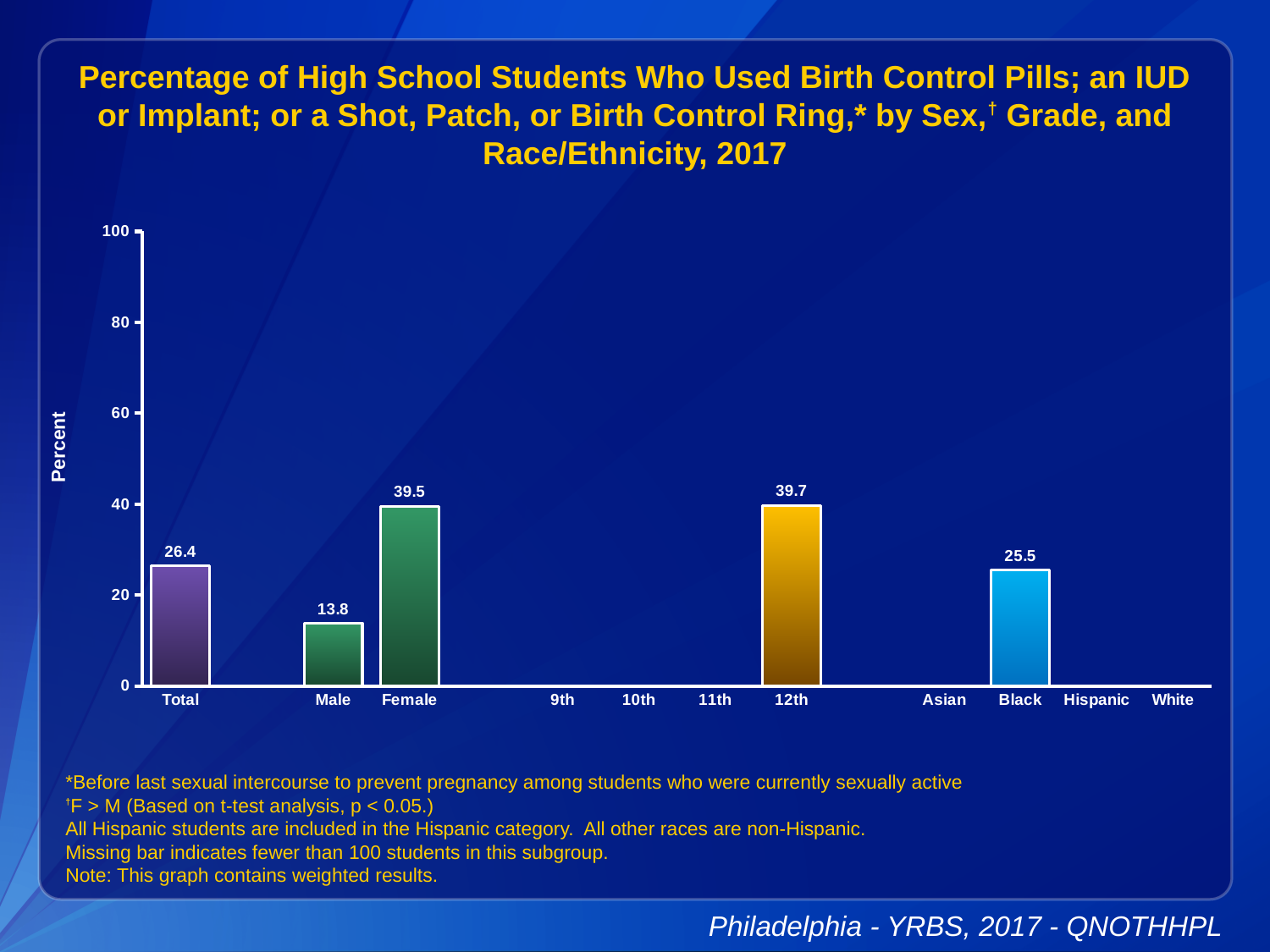
What is the value for Black students? 25.5 Which category has the lowest plotted value? Male What is the value for Female? 39.5 What is the value for Male? 13.8 What is the difference between the Female and Male values? 25.7 How many bars are plotted on the chart? 5 What is the value for 12th grade? 39.7 What kind of chart is shown? bar chart What is the label of the y axis? Percent What is the value for Total? 26.4 Is the value for Female greater or less than 20? greater Which is larger, the value for Total or the value for Black? Total